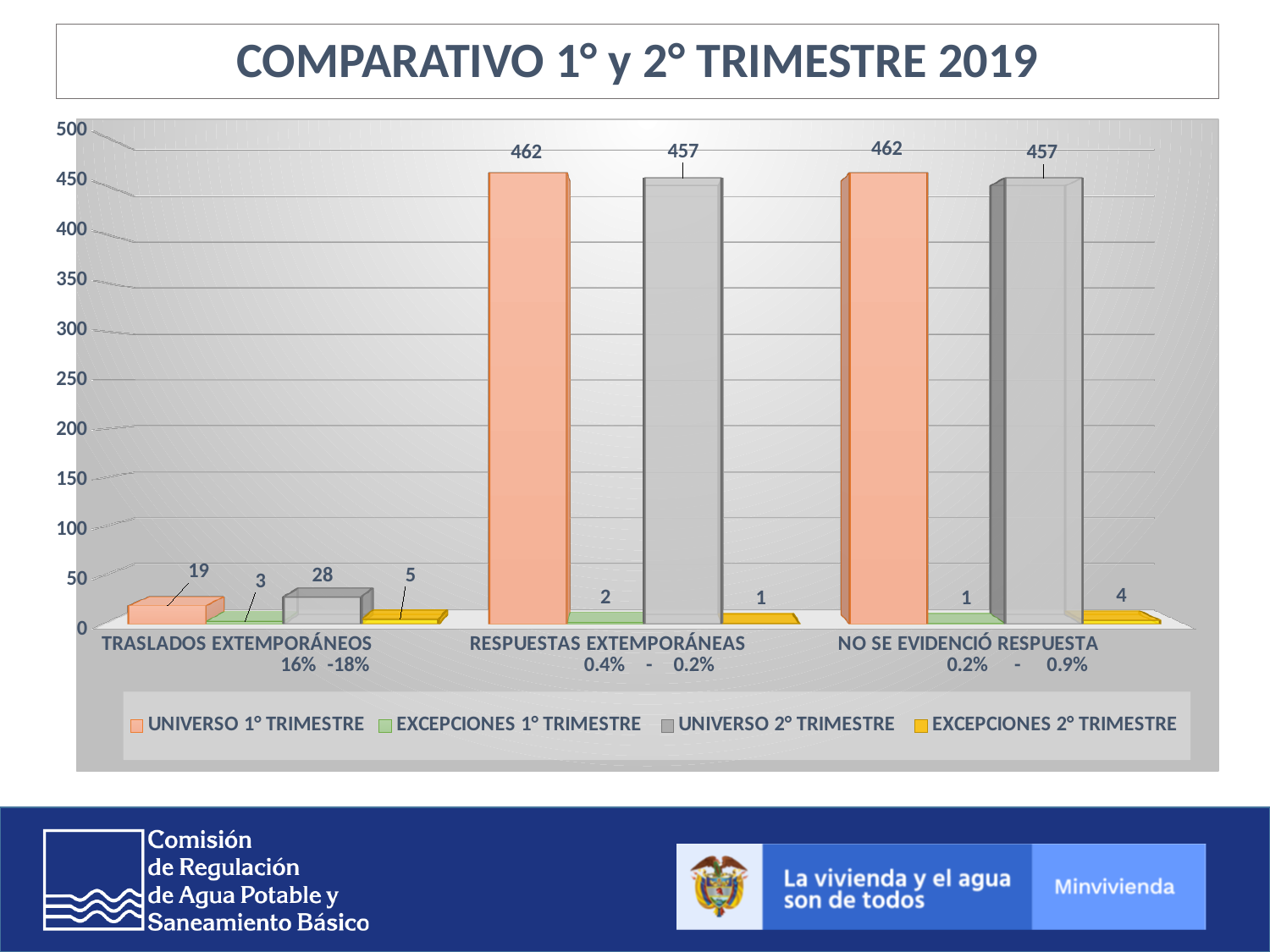
For TRASLADOS EXTEMPORÁNEOS, which is larger: UNIVERSO 1° TRIMESTRE or UNIVERSO 2° TRIMESTRE? UNIVERSO 2° TRIMESTRE What is the value of UNIVERSO 2° TRIMESTRE for RESPUESTAS EXTEMPORÁNEAS? 457 What is the difference between UNIVERSO 2° TRIMESTRE and UNIVERSO 1° TRIMESTRE for TRASLADOS EXTEMPORÁNEOS? 9 What is the difference between UNIVERSO 1° TRIMESTRE and UNIVERSO 2° TRIMESTRE for RESPUESTAS EXTEMPORÁNEAS? 5 How many series does the legend list? 4 Which category has the lowest value for UNIVERSO 2° TRIMESTRE? TRASLADOS EXTEMPORÁNEOS What is the value of EXCEPCIONES 1° TRIMESTRE for TRASLADOS EXTEMPORÁNEOS? 3 What is the value of EXCEPCIONES 2° TRIMESTRE for NO SE EVIDENCIÓ RESPUESTA? 4 How many categories are shown on the x axis? 3 What type of chart is shown on the slide? Bar chart What is the value of UNIVERSO 1° TRIMESTRE for TRASLADOS EXTEMPORÁNEOS? 19 Is the value of UNIVERSO 1° TRIMESTRE for NO SE EVIDENCIÓ RESPUESTA greater or less than 450? greater